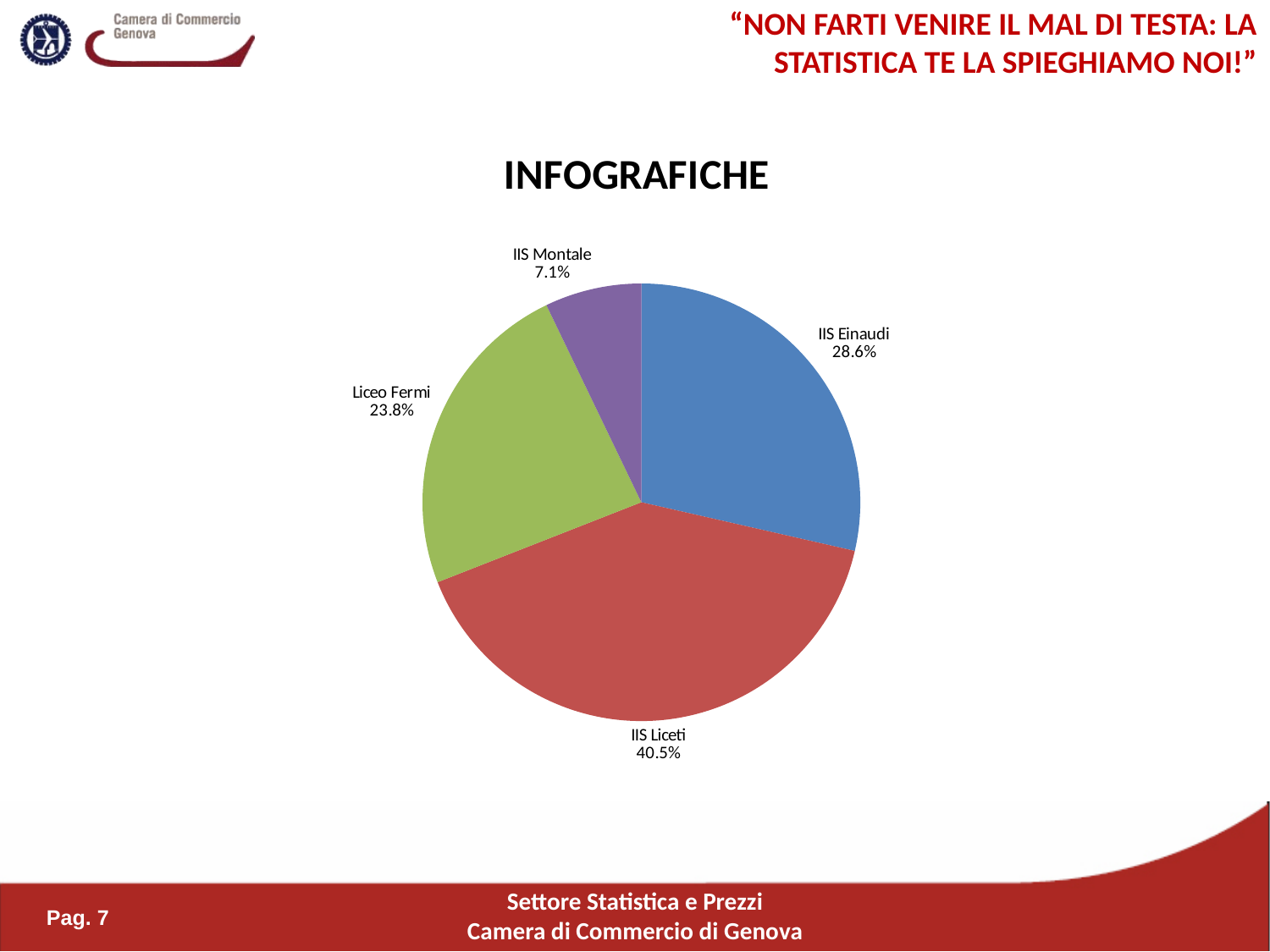
Which is larger, the share for IIS Einaudi or the share for Liceo Fermi? IIS Einaudi What is the share for IIS Einaudi? 28.6% Which school has the largest slice of the pie? IIS Liceti How many slices does the pie chart have? 4 What kind of chart is shown on the slide? pie chart What is the share for Liceo Fermi? 23.8% Which school has the smallest slice of the pie? IIS Montale What colour is the IIS Liceti slice? red What is the difference in percentage points between Liceo Fermi and IIS Montale? 16.7 What is the share for IIS Montale? 7.1% What is the difference in percentage points between IIS Liceti and IIS Einaudi? 11.9 What is the share for IIS Liceti? 40.5%